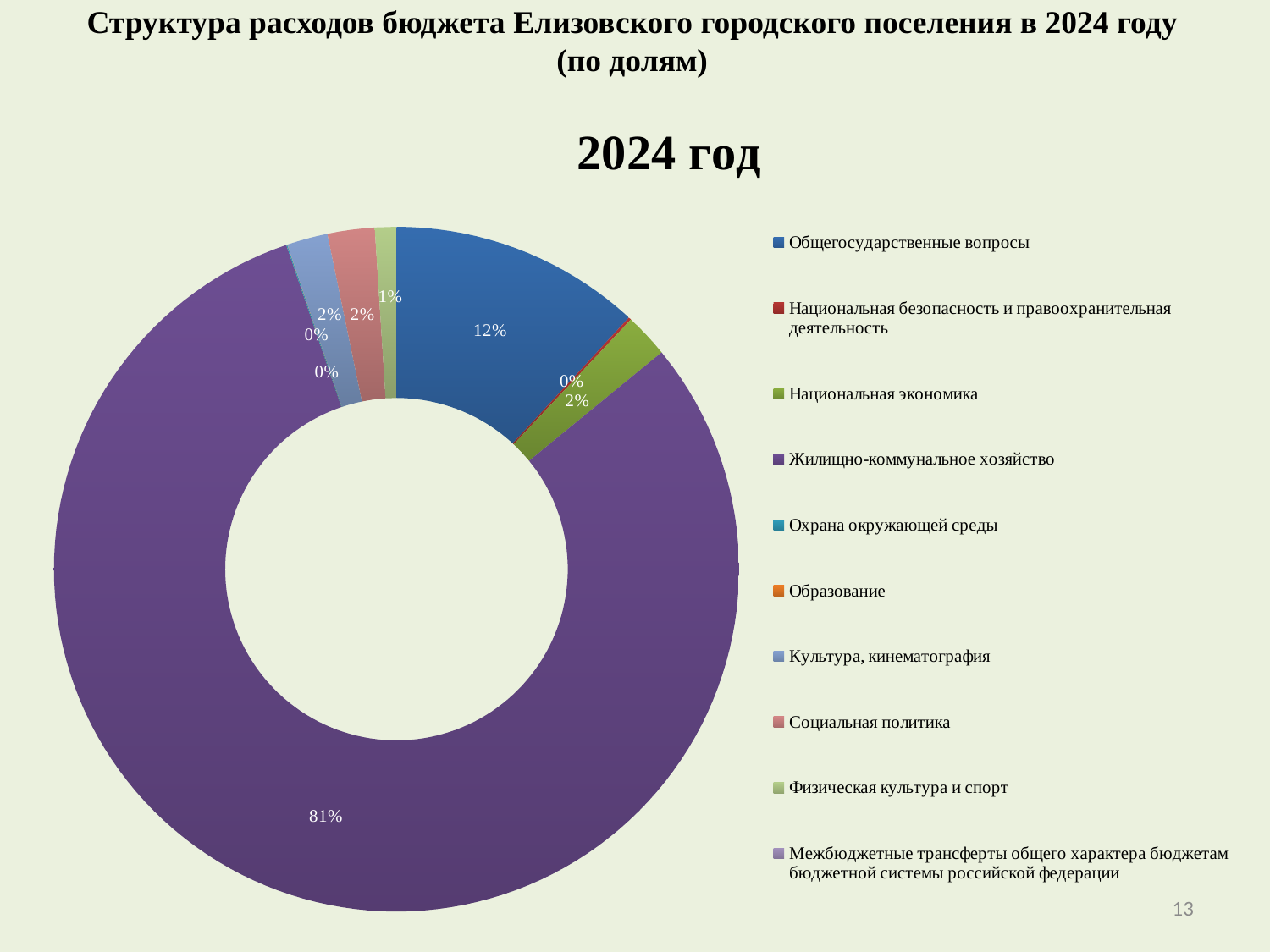
How many categories does the legend list? 10 Which expenditure category has the largest share in the chart? Жилищно-коммунальное хозяйство What year is shown in the heading above the chart? 2024 год What share of the 2024 budget expenditure goes to Общегосударственные вопросы? 12% What share of the 2024 budget expenditure goes to Социальная политика? 2% What colour is the largest slice of the chart? Purple By how many percentage points does the share of Жилищно-коммунальное хозяйство exceed the share of Общегосударственные вопросы? 69 percentage points What share of the 2024 budget expenditure goes to Национальная экономика? 2% What share of the 2024 budget expenditure goes to Физическая культура и спорт? 1% What share of the 2024 budget expenditure goes to Жилищно-коммунальное хозяйство? 81% Which has the larger share: Общегосударственные вопросы or Национальная экономика? Общегосударственные вопросы What kind of chart is shown on the slide? Doughnut (pie) chart